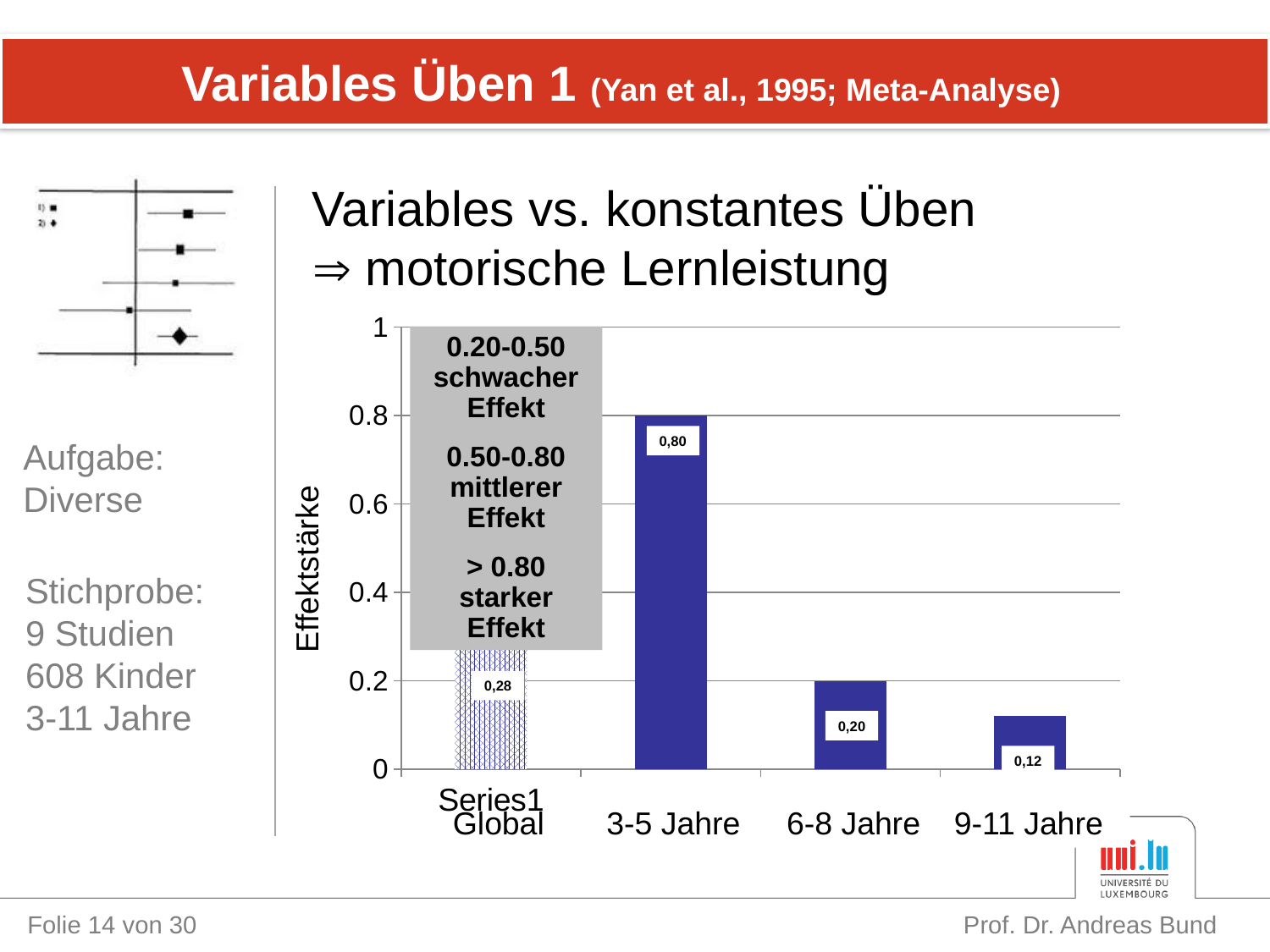
Which is larger, the effect size for Global or for 6-8 Jahre? Global How many categories are shown on the x axis of the chart? 4 What is the label of the y axis of the chart? Effektstärke What is the effect size (Effektstärke) shown for the 3-5 Jahre group? 0,80 Which category has the lowest effect size? 9-11 Jahre Which category has the highest effect size? 3-5 Jahre What kind of chart is shown on the slide? Bar chart Is the value for 3-5 Jahre greater or less than 0.6? greater What is the effect size shown for the 6-8 Jahre group? 0,20 What is the difference between the effect sizes for 3-5 Jahre and 6-8 Jahre? 0,60 What is the value of the Global bar? 0,28 What is the effect size shown for the 9-11 Jahre group? 0,12